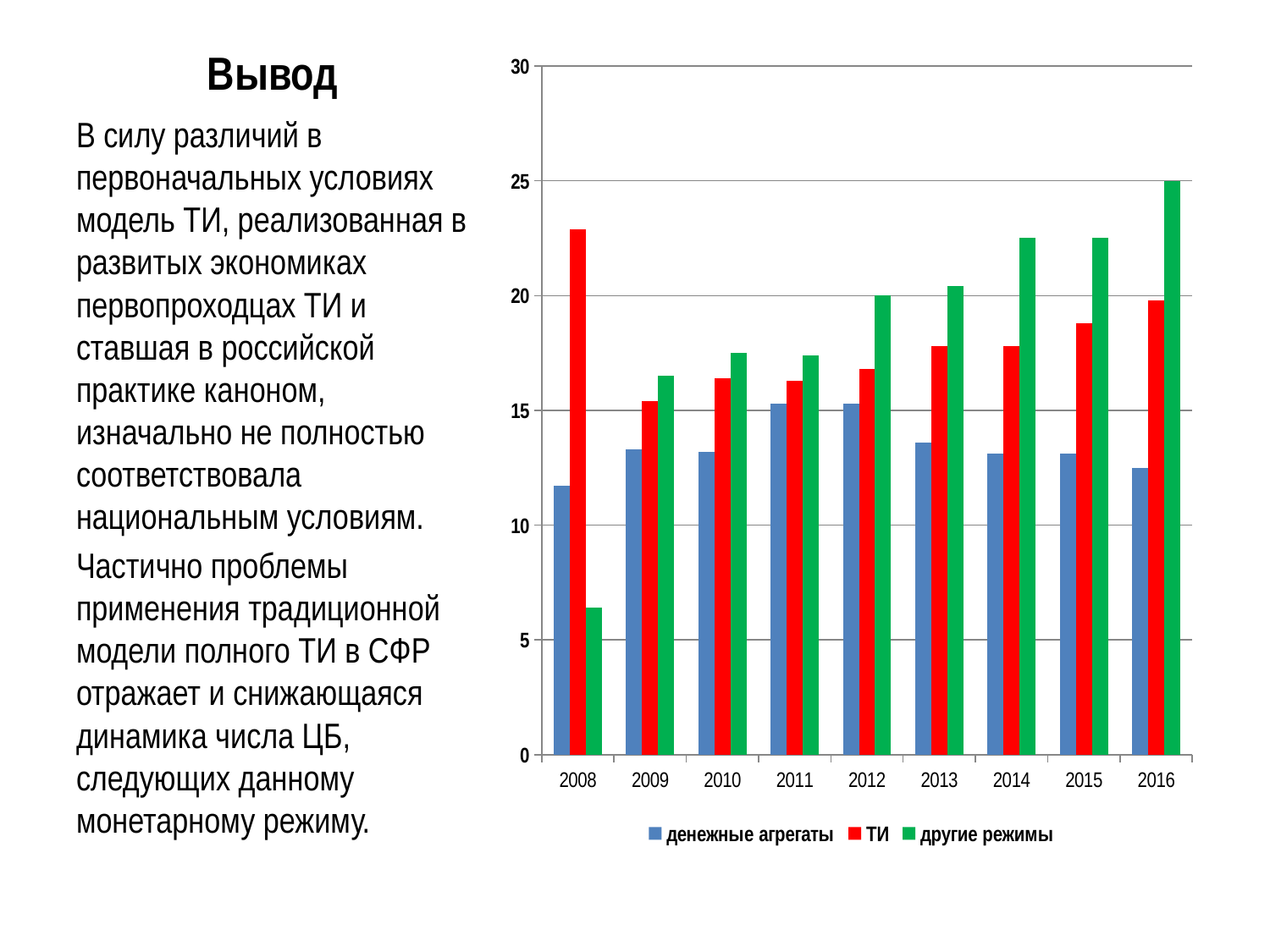
Does the value for 'другие режимы' generally rise or fall from 2008 to 2016? rise In 2008, which is larger: 'ТИ' or 'другие режимы'? ТИ Which year has the highest value for 'ТИ'? 2008 Which year has the highest value for 'другие режимы'? 2016 Which year has the lowest value for 'другие режимы'? 2008 How many years are shown on the x axis? 9 Is the value for 'другие режимы' in 2008 greater or less than 10? less Is the value for 'другие режимы' in 2014 greater or less than 20? greater What kind of chart is shown on the slide? bar chart How many series does the legend list? 3 Is the value for 'ТИ' in 2008 greater or less than 20? greater